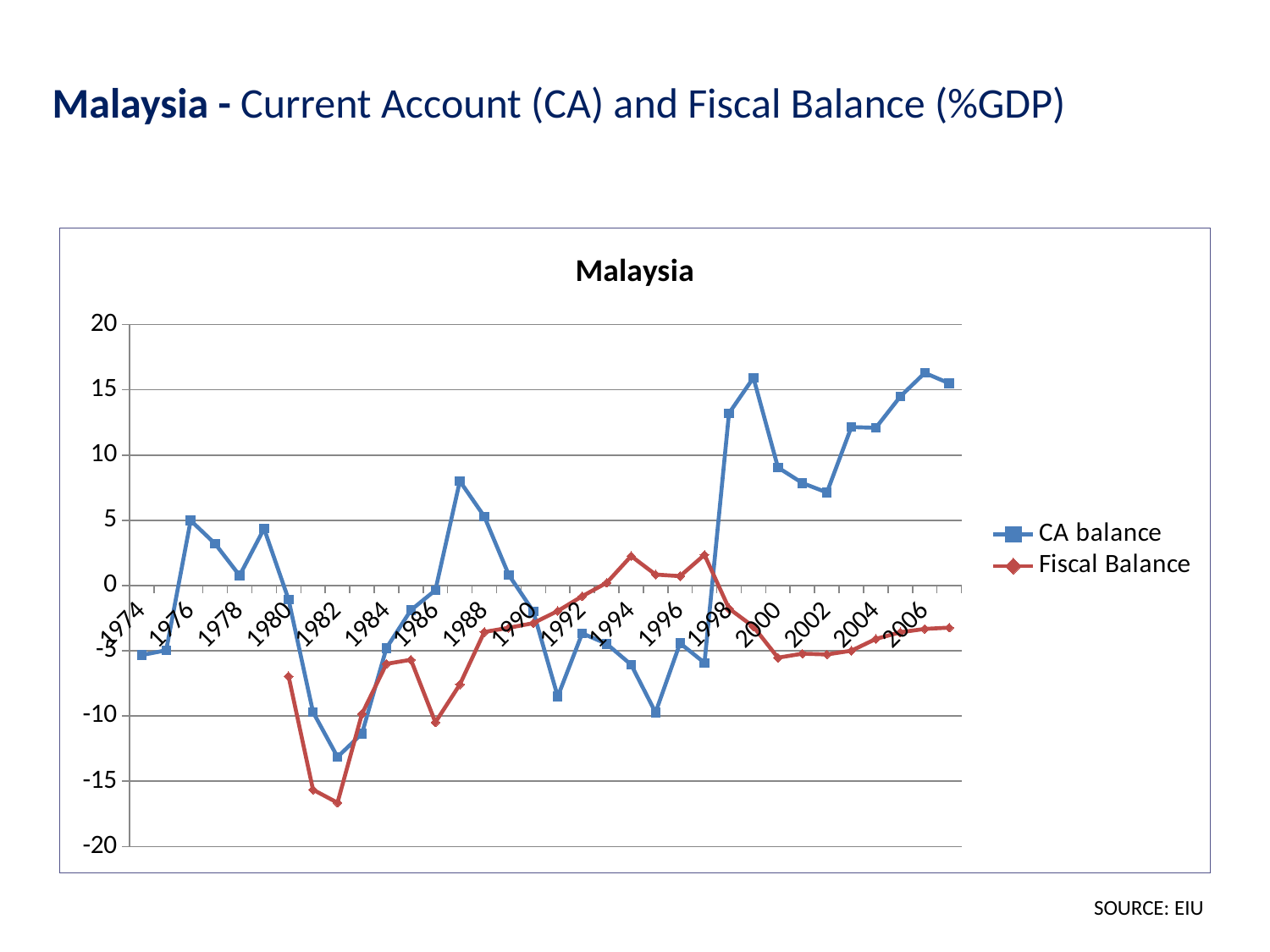
Does the CA balance rise or fall from 2002 to 2007? rise Is the CA balance in 1982 greater or less than -10? less In 1995, which is larger, the CA balance or the Fiscal Balance? Fiscal Balance Is the Fiscal Balance in 1980 greater or less than -5? less Is the CA balance in 1995 greater or less than -5? less In which year is the CA balance at its lowest? 1982 What is the title printed inside the chart area? Malaysia In 1998, which is larger, the CA balance or the Fiscal Balance? CA balance What are the two series named in the legend? CA balance and Fiscal Balance How many series does the legend list? 2 What kind of chart is shown on the slide? Line chart